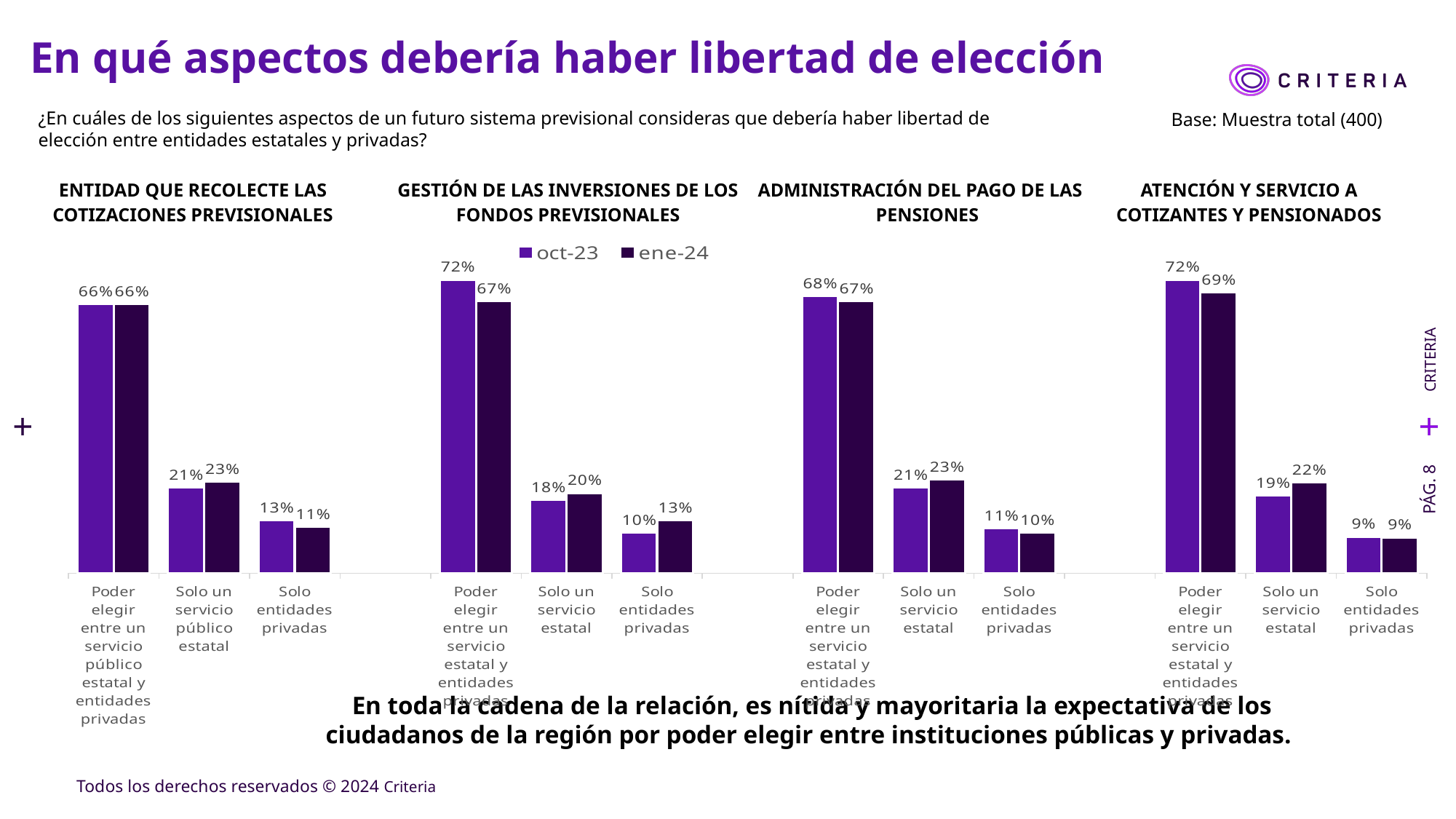
How many categories are shown on the x axis of the chart titled 'ADMINISTRACIÓN DEL PAGO DE LAS PENSIONES'? 3 In the chart titled 'ATENCIÓN Y SERVICIO A COTIZANTES Y PENSIONADOS', which category has the lowest ene-24 value? Solo entidades privadas In the chart titled 'GESTIÓN DE LAS INVERSIONES DE LOS FONDOS PREVISIONALES', what is the difference between the oct-23 and ene-24 values for 'Poder elegir entre un servicio estatal y entidades privadas'? 5% What kind of chart is the chart titled 'ATENCIÓN Y SERVICIO A COTIZANTES Y PENSIONADOS'? Bar chart In the chart titled 'ENTIDAD QUE RECOLECTE LAS COTIZACIONES PREVISIONALES', what is the oct-23 value for 'Solo un servicio público estatal'? 21% In the chart titled 'ADMINISTRACIÓN DEL PAGO DE LAS PENSIONES', what is the oct-23 value for 'Poder elegir entre un servicio estatal y entidades privadas'? 68% In the chart titled 'ATENCIÓN Y SERVICIO A COTIZANTES Y PENSIONADOS', what is the ene-24 value for 'Solo un servicio estatal'? 22% In the chart titled 'GESTIÓN DE LAS INVERSIONES DE LOS FONDOS PREVISIONALES', which category has the highest oct-23 value? Poder elegir entre un servicio estatal y entidades privadas In the chart titled 'GESTIÓN DE LAS INVERSIONES DE LOS FONDOS PREVISIONALES', what is the ene-24 value for 'Solo entidades privadas'? 13% How many series does the legend on the slide list? 2 What are the two series named in the legend on the slide? oct-23 and ene-24 In the chart titled 'ENTIDAD QUE RECOLECTE LAS COTIZACIONES PREVISIONALES', which is larger for 'Solo entidades privadas': the oct-23 value or the ene-24 value? oct-23